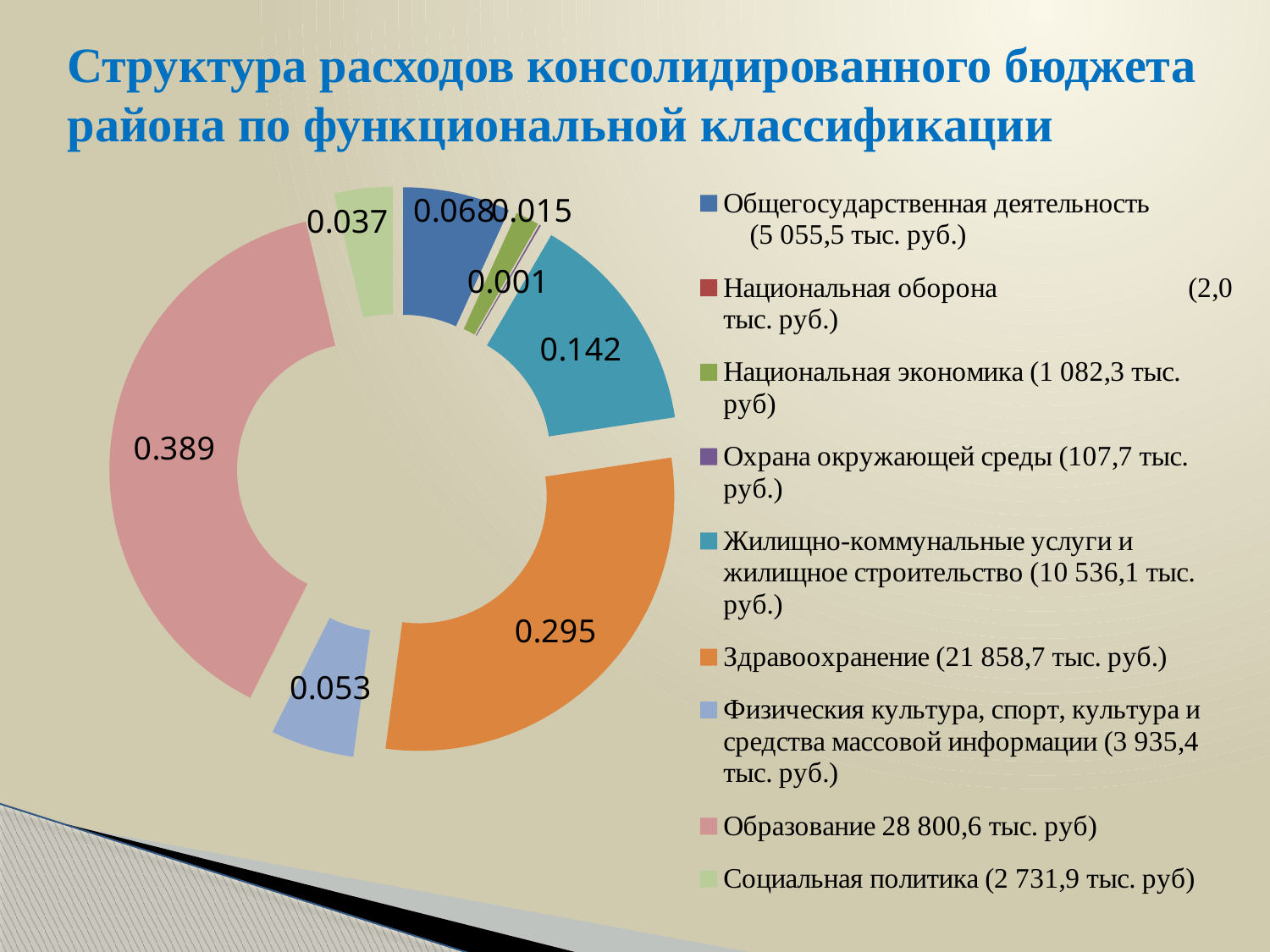
What kind of chart is shown on the slide? Doughnut (pie) chart What is the share shown for Жилищно-коммунальные услуги и жилищное строительство? 0.142 According to the legend, what amount in thousand rubles is given for Здравоохранение? 21 858,7 тыс. руб. What is the share shown for Социальная политика? 0.037 What colour is the Образование slice? Pink What is the share shown for Физическия культура, спорт, культура и средства массовой информации? 0.053 What is the share shown for Общегосударственная деятельность? 0.068 How many categories does the legend list? 9 Which category has the largest share of expenditures? Образование Which is larger, the share for Здравоохранение or the share for Жилищно-коммунальные услуги и жилищное строительство? Здравоохранение What is the difference between the share for Образование and the share for Здравоохранение? 0.094 What is the share shown for Здравоохранение? 0.295